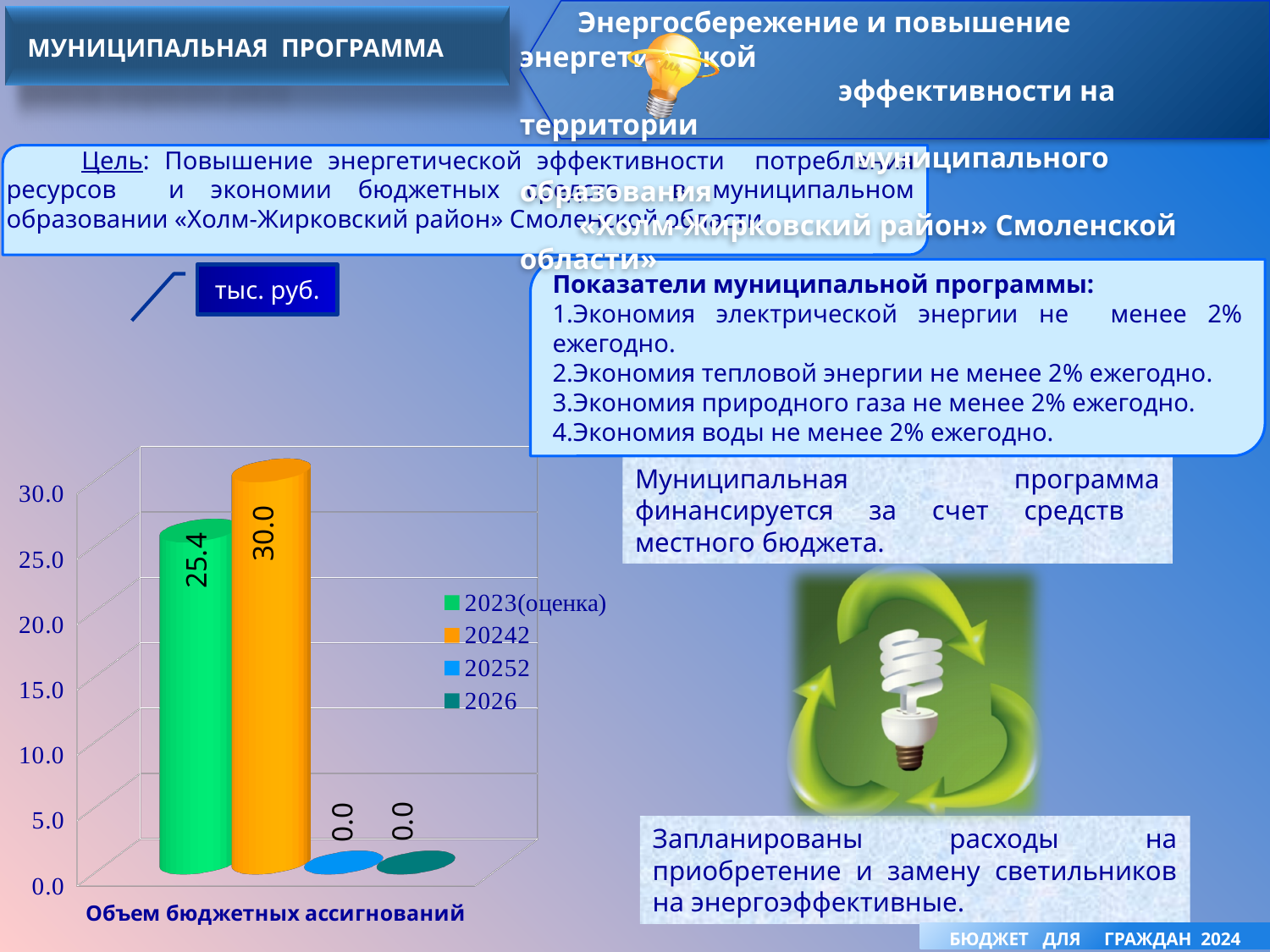
Which is larger, the value for 2023(оценка) or the value for 20242? 20242 What is the difference between the 20242 value and the 2023(оценка) value? 4.6 What is the category label shown below the chart? Объем бюджетных ассигнований What unit is indicated for the chart values? тыс. руб. How many series have a value of 0.0? 2 What type of chart is shown on the slide? bar chart Which series has the highest value? 20242 What is the value for the 2023(оценка) series? 25.4 How many series does the legend list? 4 What is the value for the 20242 series? 30.0 Is the value for 2023(оценка) greater or less than 20.0? greater What is the value for the 2026 series? 0.0